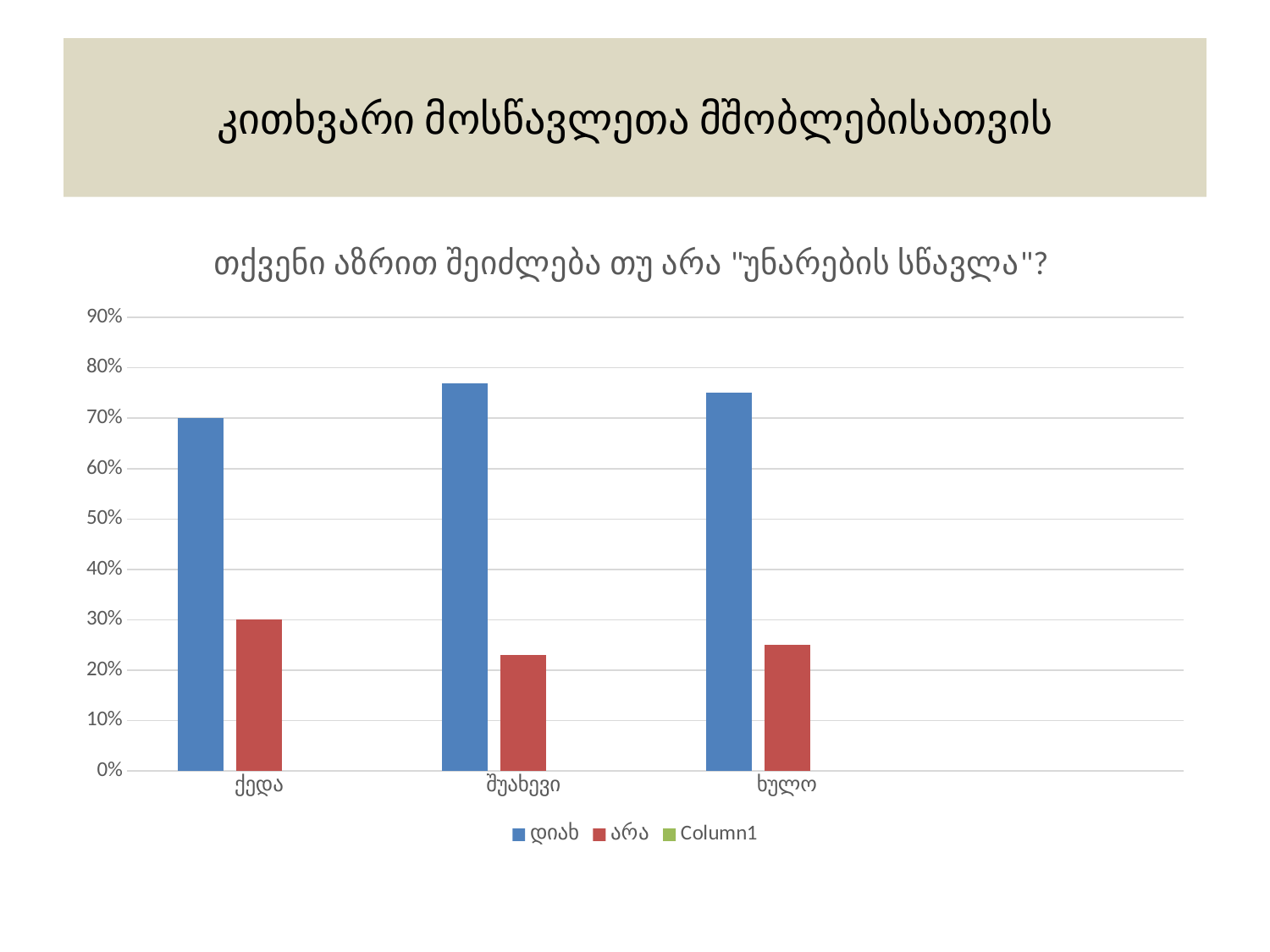
Is the value of დიახ for შუახევი greater or less than 70%? greater Which category has the highest დიახ value? შუახევი How many categories are shown on the x axis of the chart? 3 Which series is shown in blue in the chart? დიახ What is the value of არა for ქედა? 30% What is the difference between დიახ and არა for ქედა? 40% Is the value of დიახ for ხულო greater or less than 80%? less Is the value of არა for შუახევი greater or less than 30%? less What is the value of დიახ for ქედა? 70% Which category has the lowest არა value? შუახევი What kind of chart is shown on the slide? bar chart How many series does the chart legend list? 3